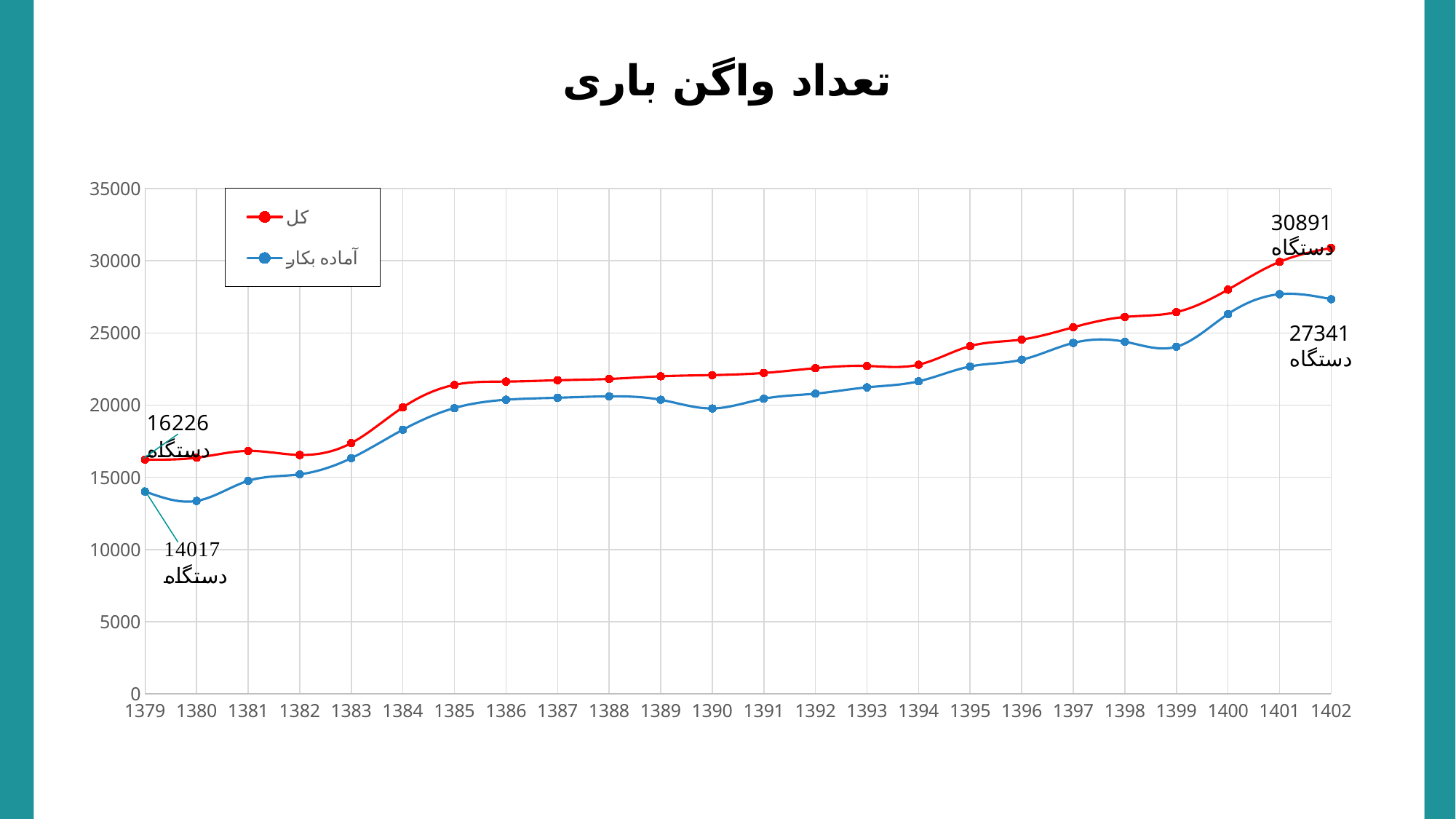
What is the value of the کل series in 1402? 30891 What is the value of the آماده بکار series in 1379? 14017 By how much did the کل series increase from 1379 to 1402? 14665 What kind of chart is shown on the slide? line chart How many years are shown on the x axis? 24 Which series has the larger value in 1402, کل or آماده بکار? کل How many series does the legend list? 2 Is the value of the کل series in 1390 greater or less than 20000? greater What is the value of the آماده بکار series in 1402? 27341 What is the difference between the کل and آماده بکار values in 1402? 3550 What is the value of the کل series in 1379? 16226